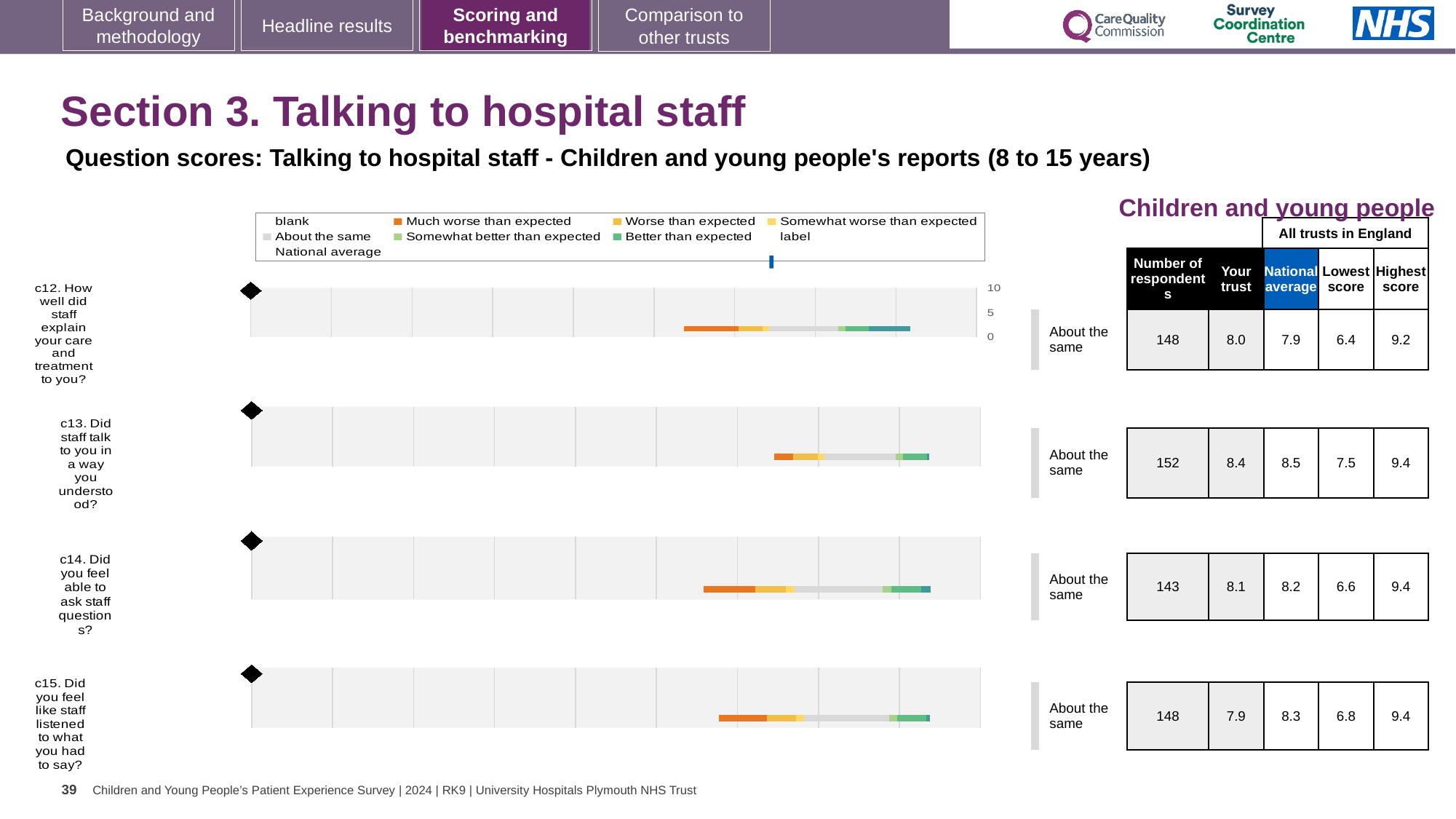
Which question has the lowest 'Your trust' score? c15 For question c14 (Did you feel able to ask staff questions?), which is larger: the 'Your trust' score or the national average? National average How many respondents answered question c13 (Did staff talk to you in a way you understood?)? 152 For question c15, what is the difference between the national average and the 'Your trust' score? 0.4 What is the lowest score among all trusts in England for question c12? 6.4 For question c15 (Did you feel like staff listened to what you had to say?), what is the national average score? 8.3 Which legend entry is shown in orange? Much worse than expected What benchmark category is shown for question c13? About the same How many survey questions (c12 to c15) are plotted on this slide? 4 What kind of chart is used to show the benchmarking for each question on this slide? bar chart For question c12 (How well did staff explain your care and treatment to you?), what is the 'Your trust' score? 8.0 Which question has the highest 'Your trust' score? c13